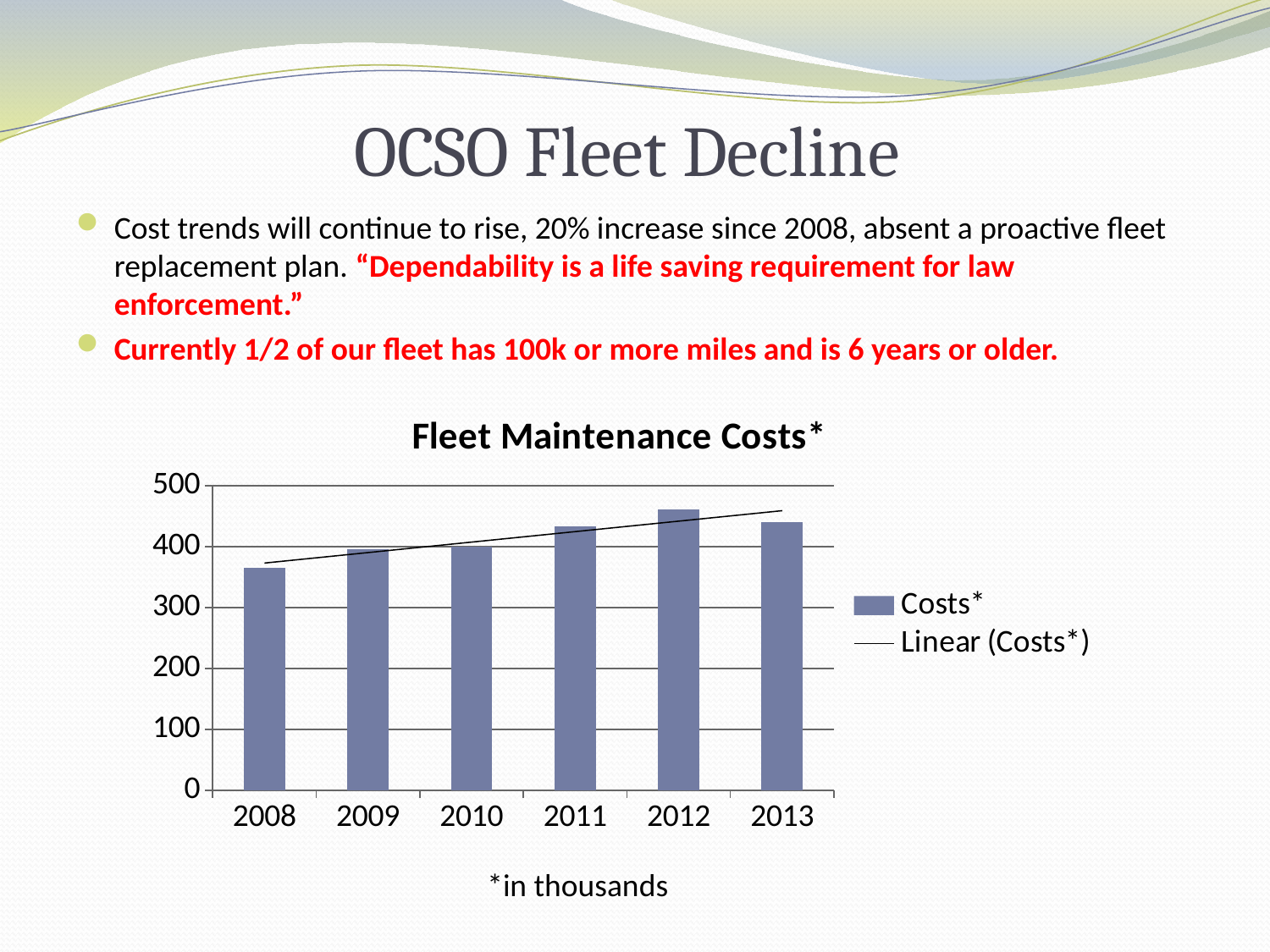
Which year has the highest fleet maintenance cost? 2012 Which year has the lowest fleet maintenance cost? 2008 Is the value for 2012 greater or less than 400? greater Do fleet maintenance costs generally rise or fall from 2008 to 2012? rise Is the value for 2008 greater or less than 400? less According to the note below the chart, in what units are the costs expressed? in thousands Which year has the larger fleet maintenance cost, 2008 or 2013? 2013 Is the value for 2011 greater or less than 400? greater How many entries does the chart's legend list? 2 How many years are shown on the x axis of the chart? 6 What is the title of the chart? Fleet Maintenance Costs* What type of chart is shown on the slide? bar chart